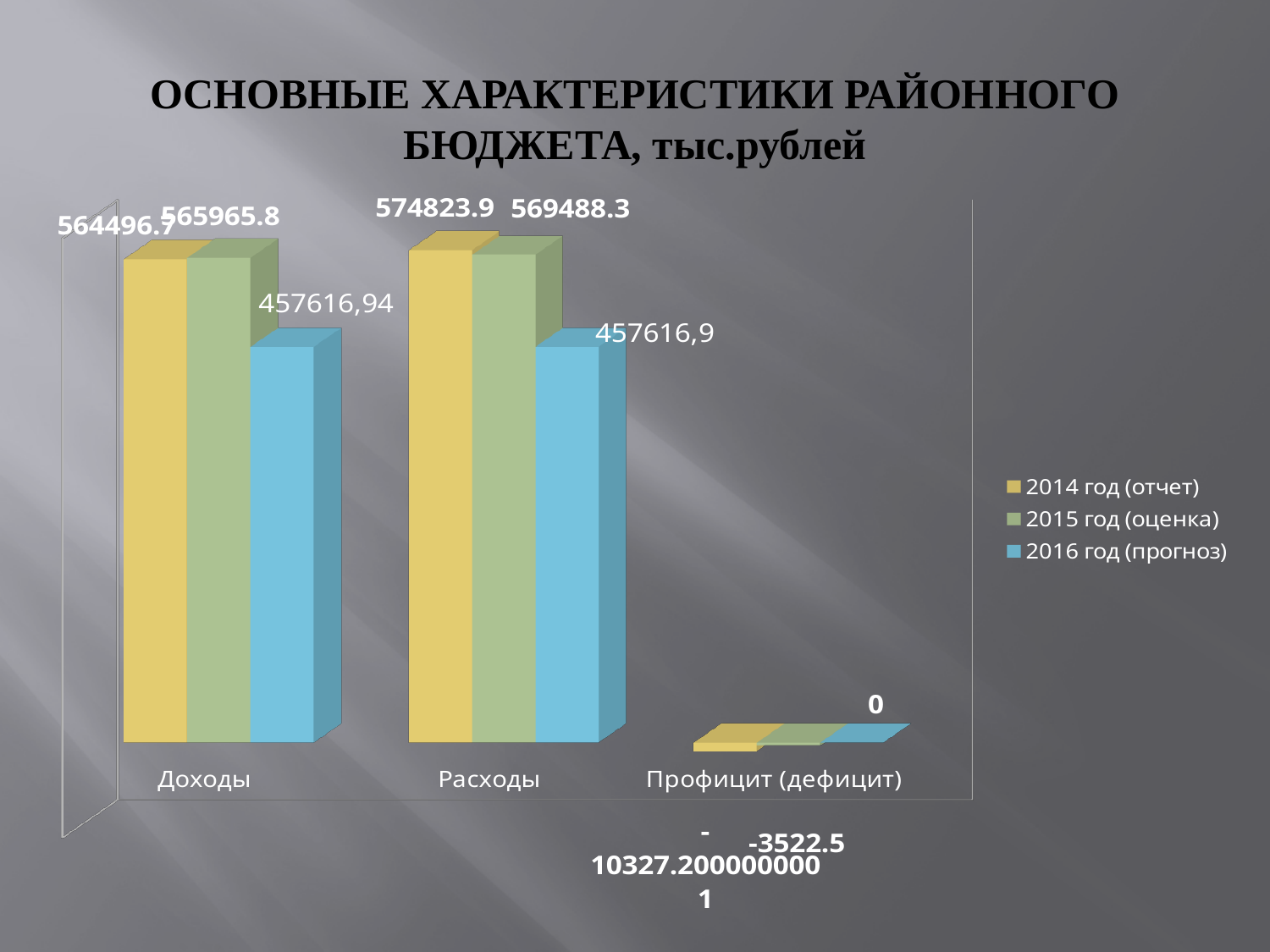
What is the value for Доходы in the 2014 год (отчет) series? 564496.7 How many series does the legend list? 3 Which category has the highest value in the 2014 год (отчет) series? Расходы What is the value for Профицит (дефицит) in the 2016 год (прогноз) series? 0 Which category has the lowest value in the 2015 год (оценка) series? Профицит (дефицит) What is the value for Доходы in the 2016 год (прогноз) series? 457616,94 What kind of chart is shown on the slide? Bar chart What is the value for Расходы in the 2015 год (оценка) series? 569488.3 Which is larger in the 2016 год (прогноз) series: Доходы or Профицит (дефицит)? Доходы How many categories are shown on the x axis? 3 What is the value for Профицит (дефицит) in the 2015 год (оценка) series? -3522.5 What is the difference between Расходы and Доходы in the 2014 год (отчет) series? 10327.2